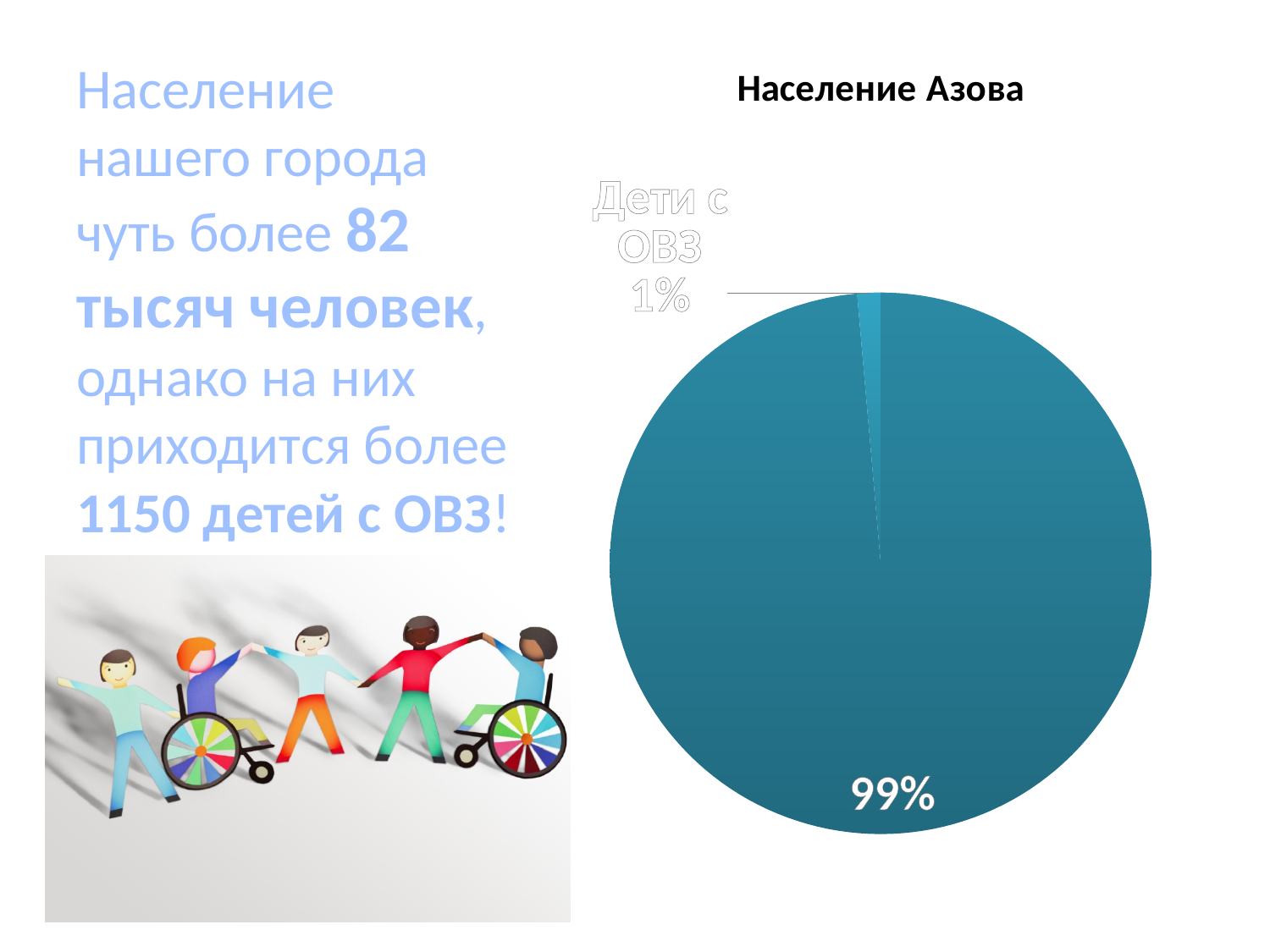
What percentage is printed on the largest slice of the pie? 99% Which slice of the pie is labelled with a category name? Дети с ОВЗ What is the difference in percentage points between the 99% slice and the "Дети с ОВЗ" slice? 98 How many slices does the pie chart have? 2 Is the slice "Дети с ОВЗ" larger or smaller than the 99% slice? smaller What kind of chart is shown on the slide? pie chart Is the share of "Дети с ОВЗ" greater or less than 50%? less Which slice is the smallest in the pie chart? Дети с ОВЗ What is the total of the two slice percentages shown on the pie chart? 100% What share of the pie does the slice "Дети с ОВЗ" represent? 1% What is the title of the chart? Население Азова